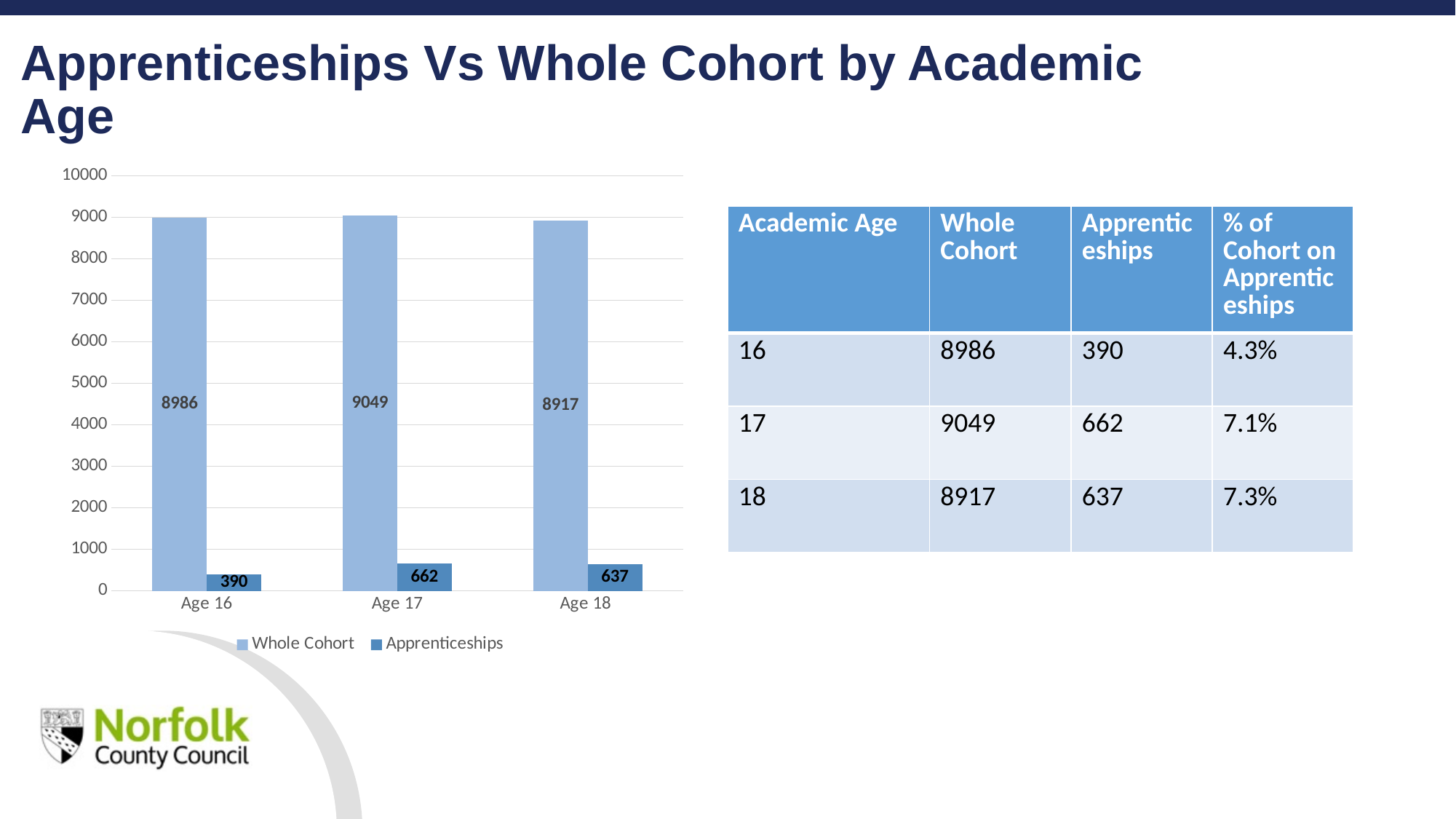
How many series does the chart legend list? 2 Is the Whole Cohort value for Age 18 greater or less than 9000? less What is the Whole Cohort value for Age 16? 8986 What is the Apprenticeships value for Age 17? 662 What is the difference between the Apprenticeships values for Age 17 and Age 16? 272 Which is larger, the Apprenticeships value for Age 17 or for Age 18? Age 17 What is the difference between the Whole Cohort values for Age 17 and Age 18? 132 How many age categories are shown on the x axis of the chart? 3 What is the Apprenticeships value for Age 18? 637 What kind of chart is shown on the slide? bar chart Which age group has the lowest Apprenticeships value? Age 16 Which age group has the highest Whole Cohort value? Age 17